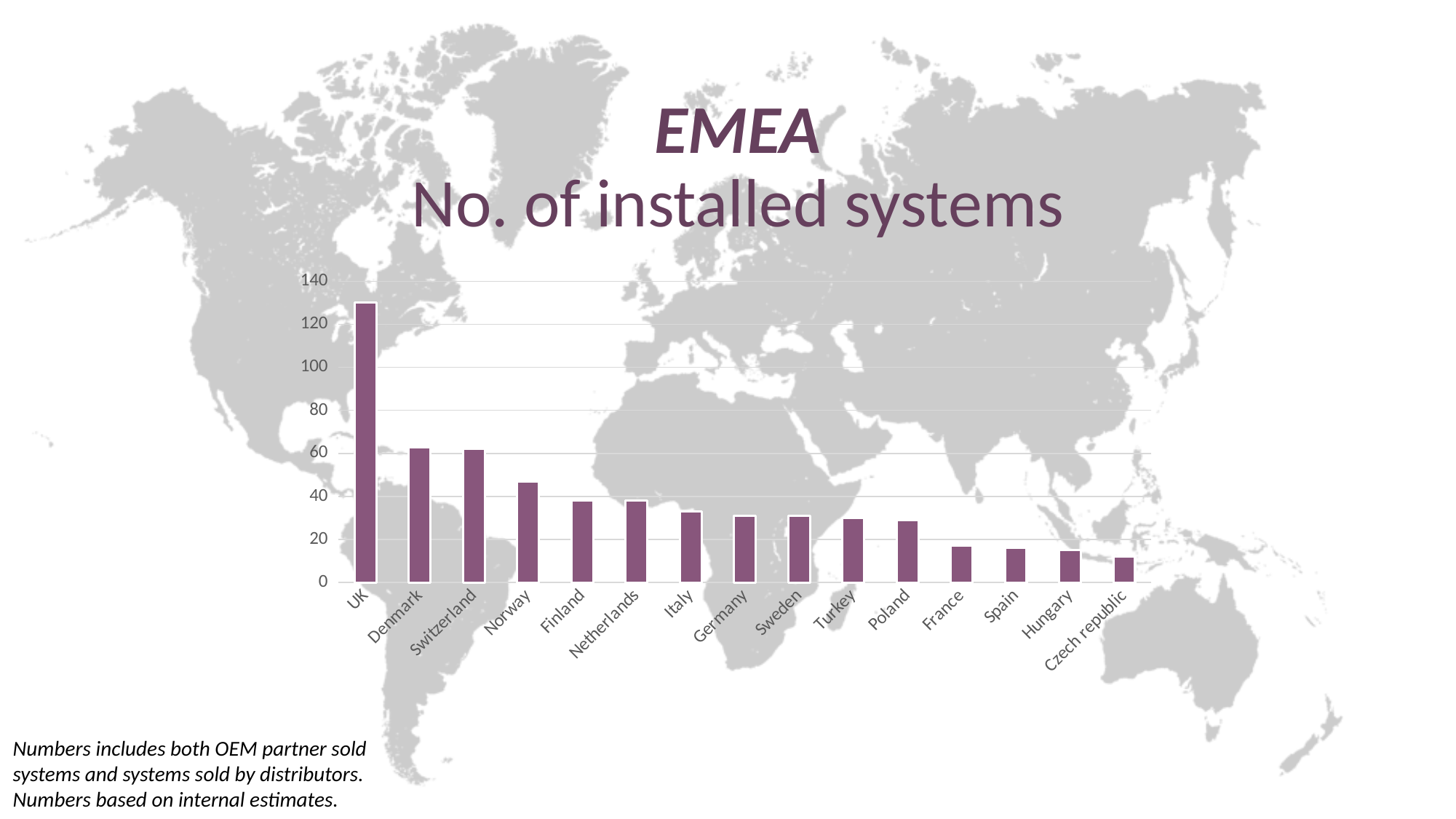
Which has more installed systems, Norway or Finland? Norway What kind of chart is shown on the slide? bar chart Do the values rise or fall moving from left to right along the x axis? fall Is the value for France greater or less than 20? less Which region does the chart title say the installed systems are for? EMEA Which has more installed systems, UK or Denmark? UK Is the value for UK greater or less than 120? greater Is the value for Italy greater or less than 40? less Which country has the highest number of installed systems? UK How many countries are shown on the x axis of the chart? 15